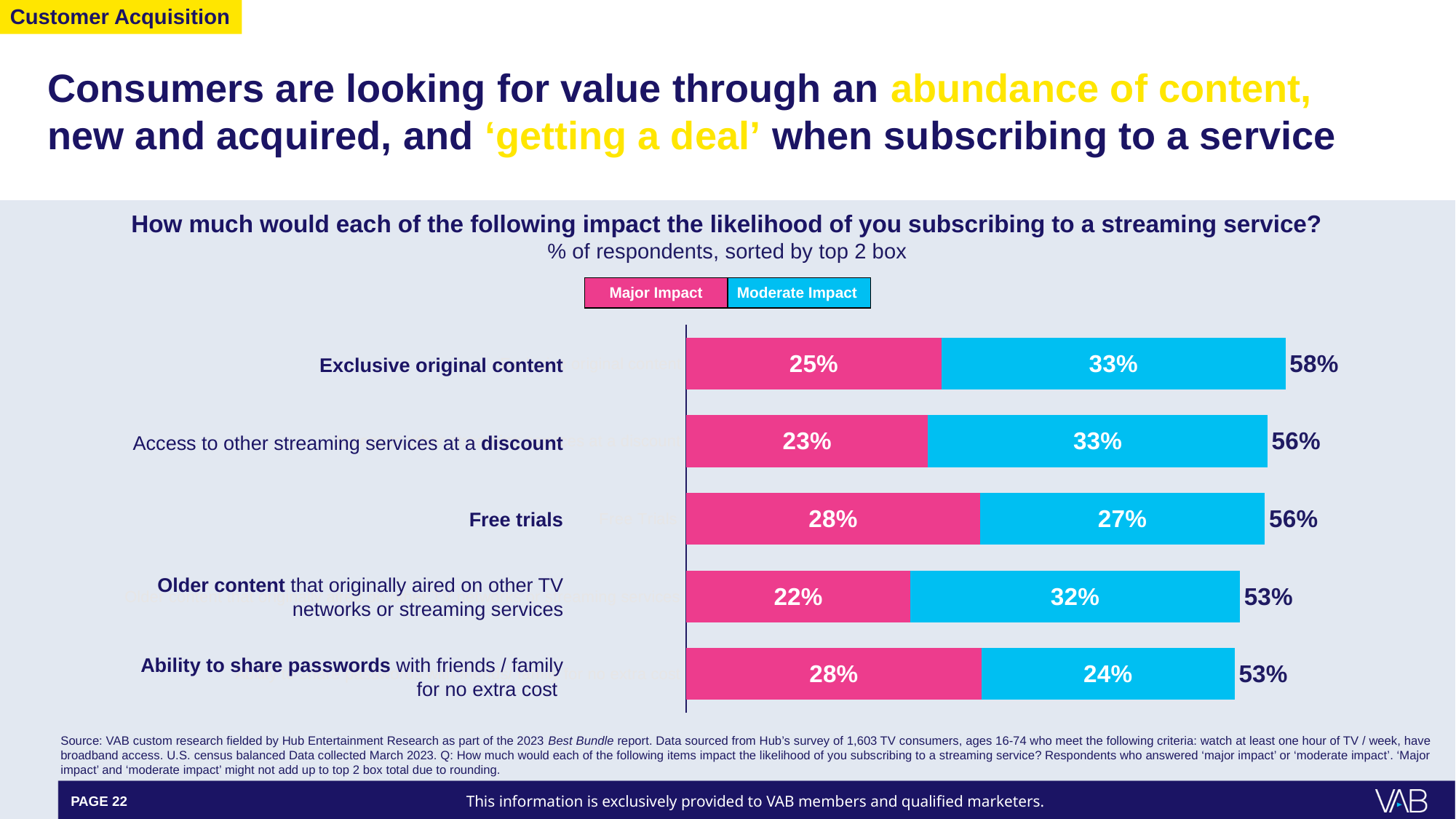
What is the difference between the Moderate Impact values for Exclusive original content and Free trials? 6% Which category has the lowest Moderate Impact value? Ability to share passwords with friends / family for no extra cost What is the Major Impact value for Older content that originally aired on other TV networks or streaming services? 22% Which colour represents Moderate Impact in the legend? Blue Which category has the highest top 2 box total? Exclusive original content What is the top 2 box total shown for Access to other streaming services at a discount? 56% Which is larger: the Major Impact value for Free trials or the Major Impact value for Access to other streaming services at a discount? Free trials What is the Moderate Impact value for Free trials? 27% What kind of chart is shown on the slide? Stacked bar chart How many categories are shown in the chart? 5 What is the Major Impact value for Exclusive original content? 25% How many series does the legend list? 2